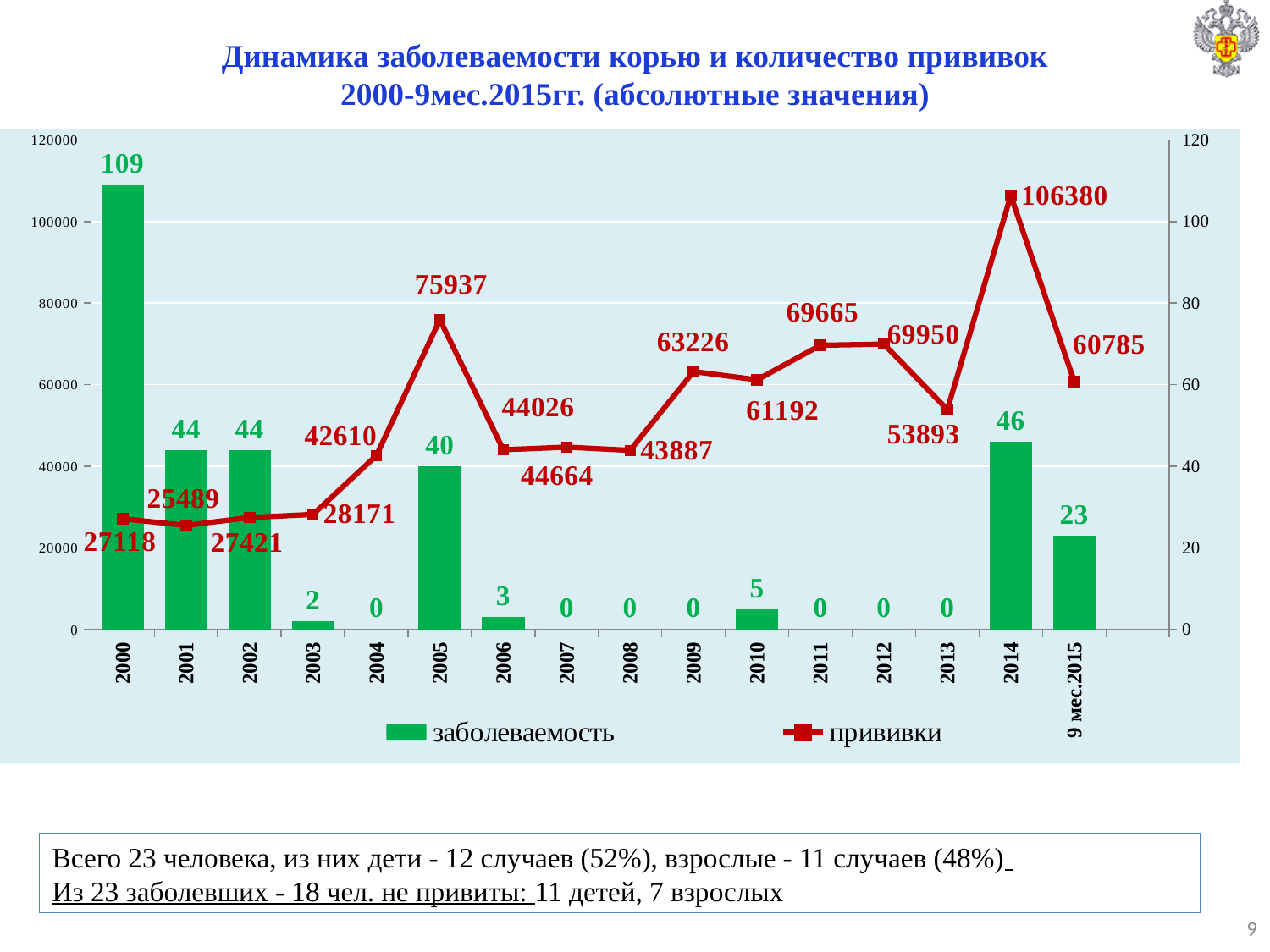
What is the difference between the прививки values for 2014 and 9 мес.2015? 45595 What is the value of заболеваемость for 9 мес.2015? 23 What kind of chart is used for the заболеваемость series? bar chart Which year has the highest value of прививки? 2014 How many years have a заболеваемость value of 0? 7 What is the value of прививки for 2005? 75937 Does the прививки value rise or fall from 2012 to 2013? fall Which year has the lowest value of прививки? 2001 Which is larger, the заболеваемость value for 2014 or for 2005? 2014 What is the value of заболеваемость for 2000? 109 How many series does the legend list? 2 What is the value of прививки for 2014? 106380